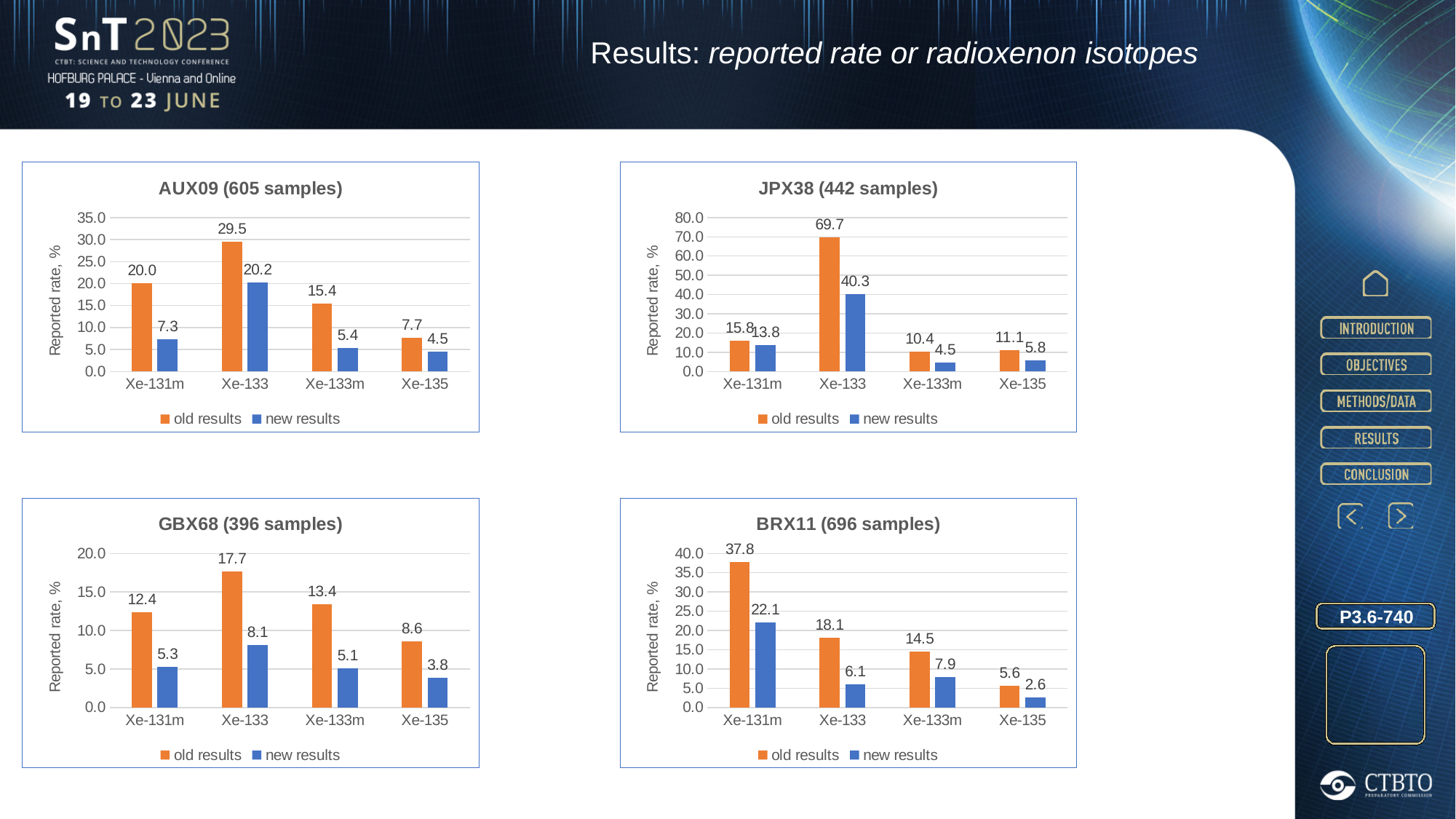
In the AUX09 (605 samples) chart, what is the difference between the old and new results for Xe-131m? 12.7 In the BRX11 (696 samples) chart, which isotope has the highest old results value? Xe-131m How many series does the legend of the BRX11 (696 samples) chart list? 2 In the GBX68 (396 samples) chart, which is larger: the old results value for Xe-133 or for Xe-133m? Xe-133 How many isotope categories are shown on the x axis of the JPX38 (442 samples) chart? 4 What type of chart is the GBX68 (396 samples) chart? Bar chart In the BRX11 (696 samples) chart, which isotope has the lowest new results value? Xe-135 In the GBX68 (396 samples) chart, what is the new results value for Xe-135? 3.8 In the JPX38 (442 samples) chart, what is the difference between the old and new results for Xe-133? 29.4 In the BRX11 (696 samples) chart, do the old results values rise or fall from Xe-131m to Xe-135? Fall In the AUX09 (605 samples) chart, what is the old results value for Xe-133? 29.5 In the JPX38 (442 samples) chart, what is the new results value for Xe-133? 40.3